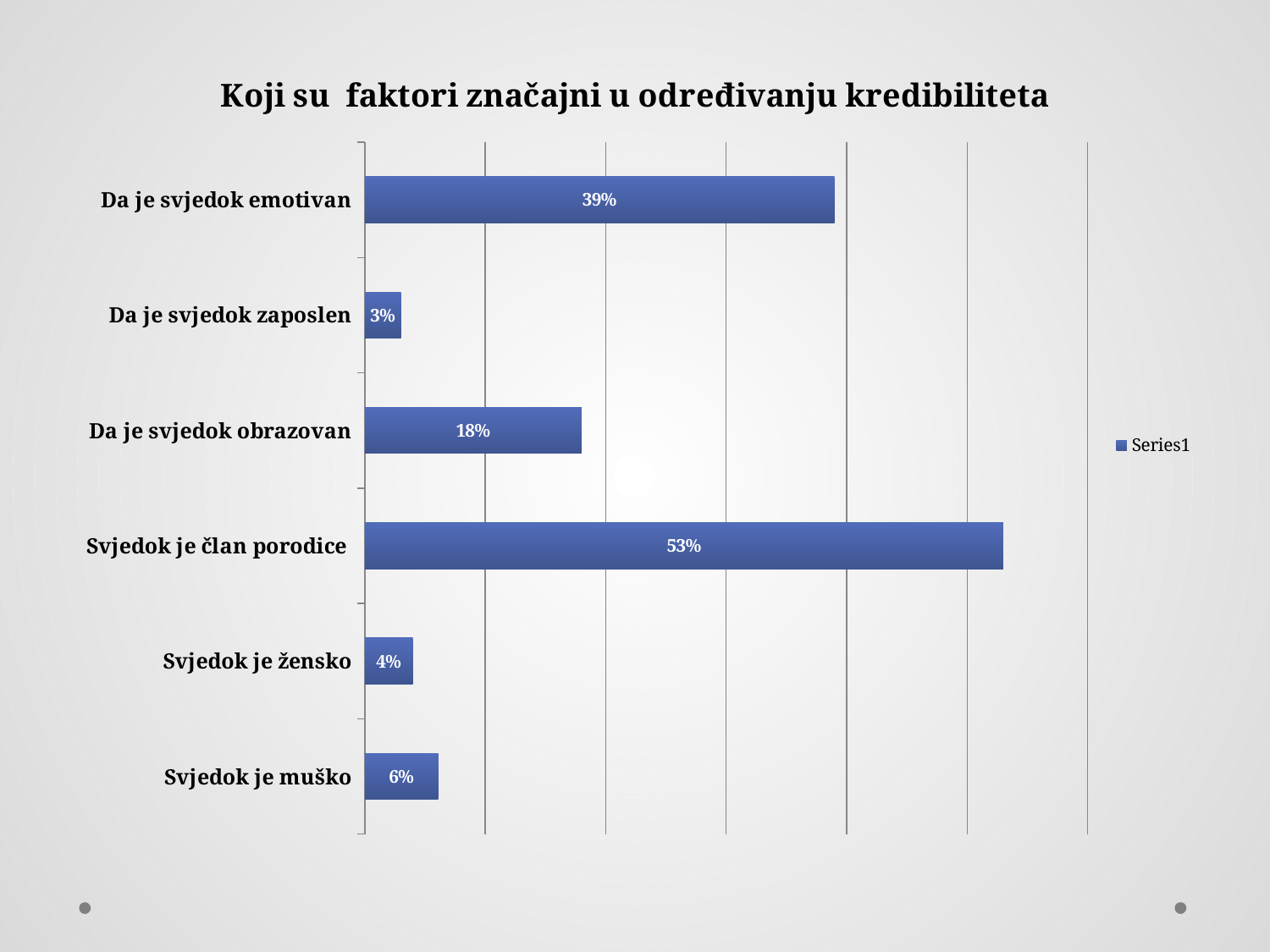
Which category has the lowest value? Da je svjedok zaposlen What is the value for "Da je svjedok emotivan"? 39% What is the value for "Svjedok je muško"? 6% How many categories are shown in the chart? 6 What is the value for "Da je svjedok obrazovan"? 18% What is the value for "Svjedok je član porodice"? 53% What is the difference between the values for "Svjedok je član porodice" and "Da je svjedok emotivan"? 14% What is the title of the chart? Koji su faktori značajni u određivanju kredibiliteta Which category has the highest value? Svjedok je član porodice What is the difference between the values for "Svjedok je muško" and "Svjedok je žensko"? 2% What kind of chart is shown on the slide? Bar chart Which is larger, the value for "Da je svjedok obrazovan" or the value for "Svjedok je muško"? Da je svjedok obrazovan